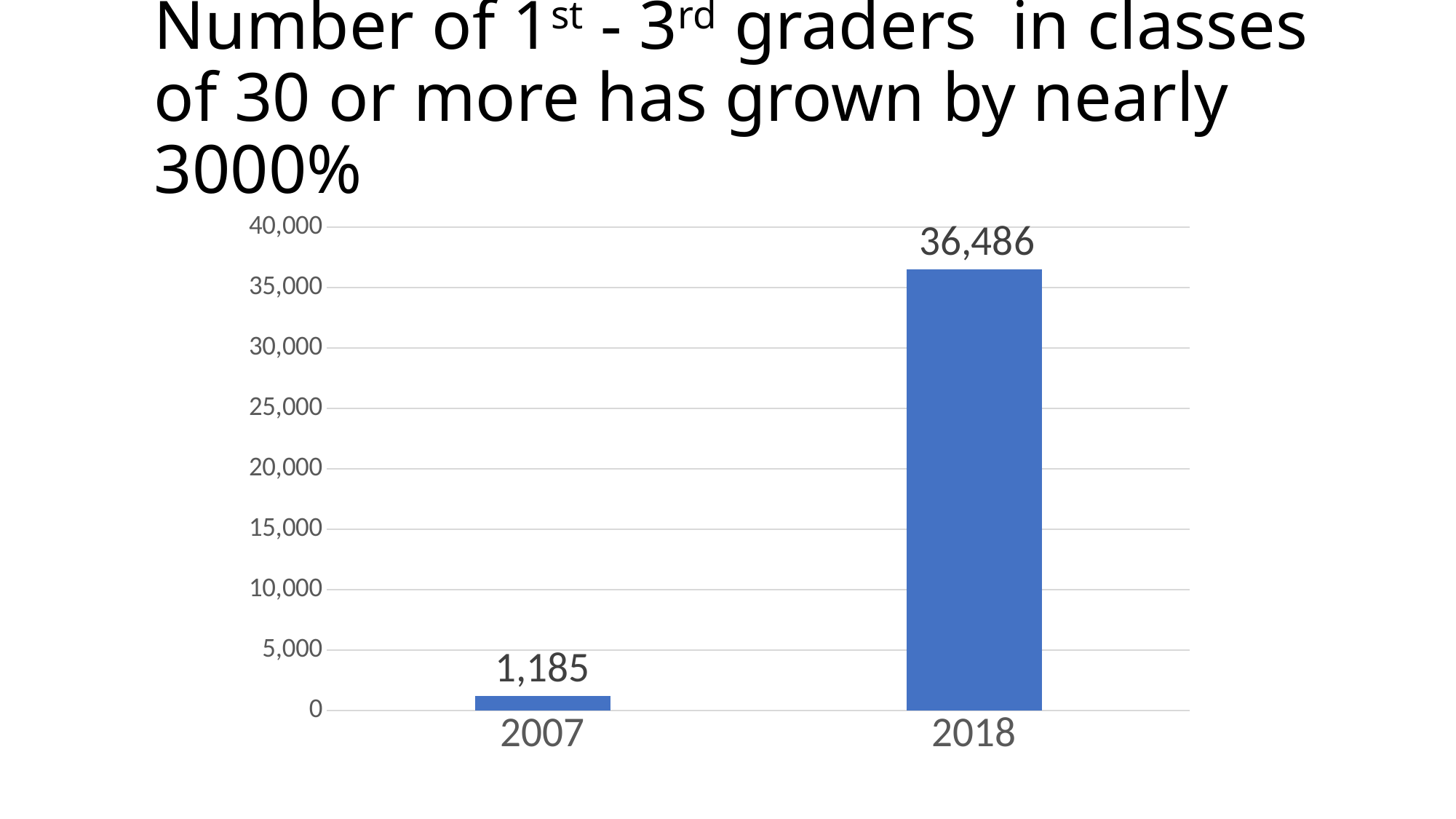
What is the value for 2018? 36,486 Is the value for 2007 greater or less than 5,000? less What kind of chart is shown on the slide? bar chart Do the values rise or fall from 2007 to 2018? rise What is the highest value shown on the y axis? 40,000 Which year has the highest value? 2018 Is the value for 2018 greater or less than 35,000? greater How many categories are shown on the x axis? 2 What is the difference between the values for 2018 and 2007? 35,301 What is the value for 2007? 1,185 Which year has the lowest value? 2007 Which is larger, the value for 2007 or the value for 2018? 2018